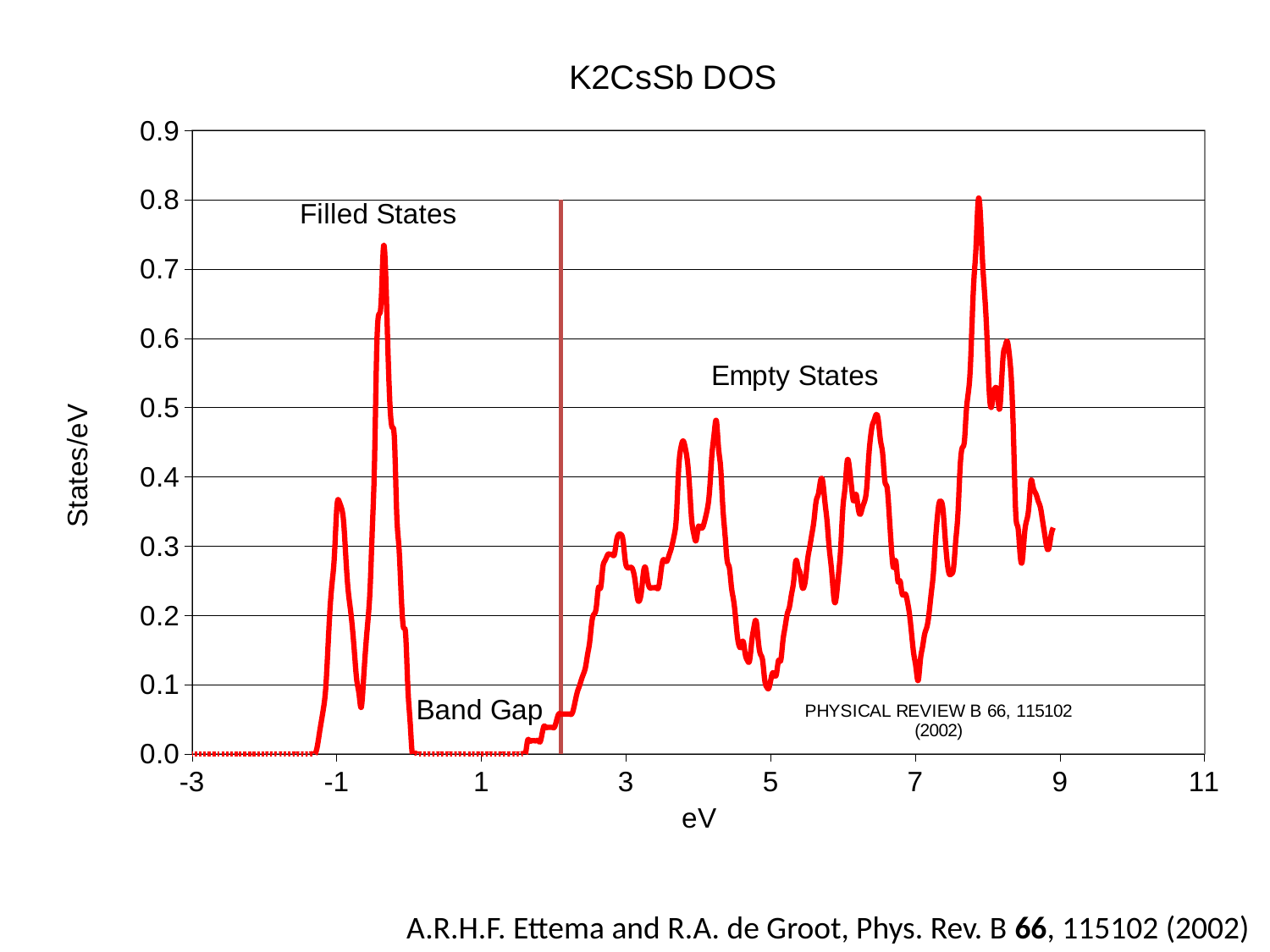
Does the curve rise or fall between 2.5 eV and 3 eV? rises Which is higher: the tallest peak in the Filled States region or the tallest peak in the Empty States region? the tallest peak in the Empty States region What kind of chart is shown on the slide? line chart What label is placed in the region between the Filled States and Empty States? Band Gap Is the value at 5 eV greater or less than 0.2 States/eV? less Is the value at 7 eV greater or less than 0.2 States/eV? less Is the highest peak in the Empty States region greater or less than 0.7 States/eV? greater What is the title of the chart? K2CsSb DOS Does the curve rise, fall, or stay flat between -3 eV and -1.5 eV? stays flat